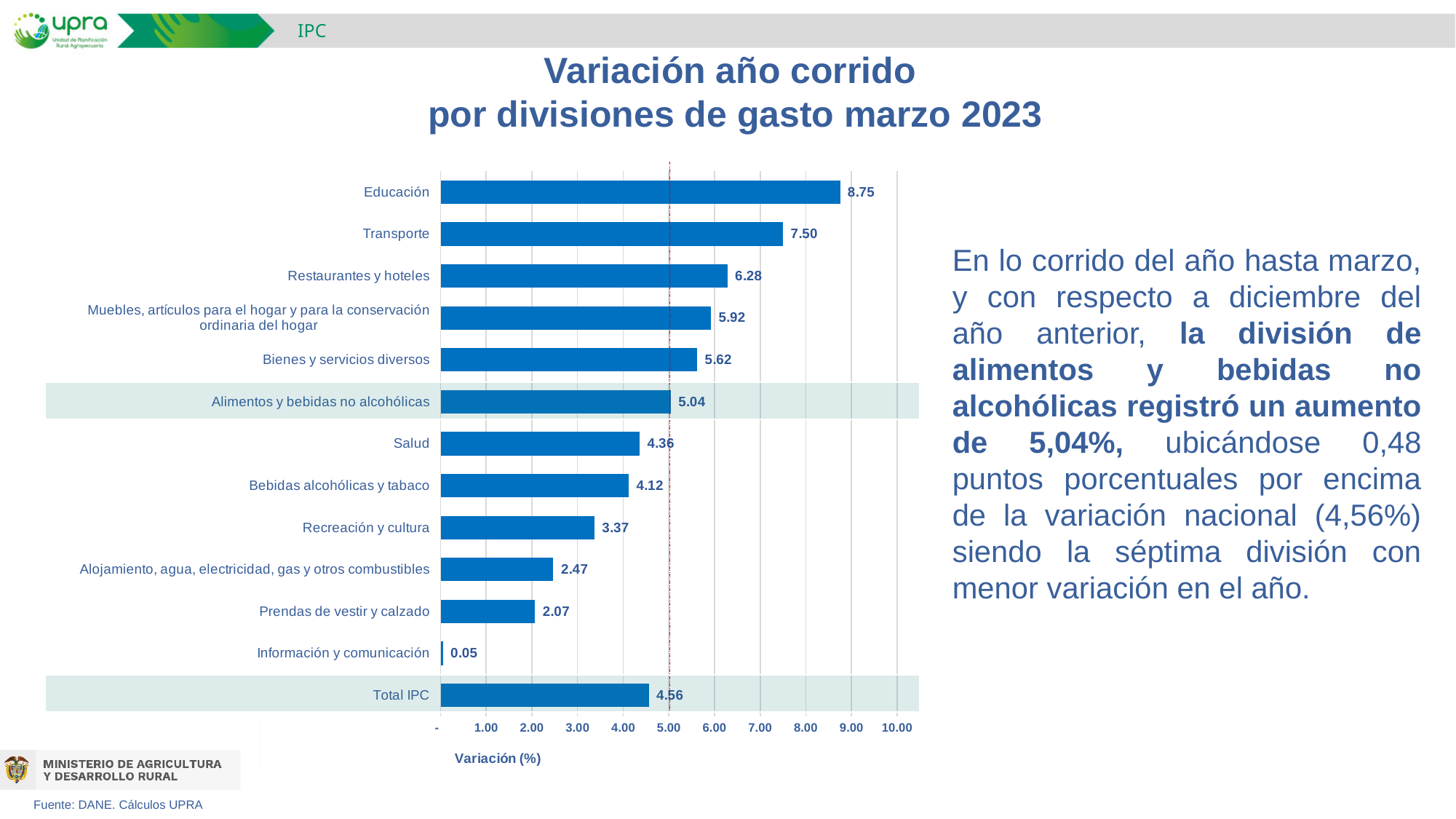
What is the value for Total IPC? 4.56 What is the difference between the values for Alimentos y bebidas no alcohólicas and Total IPC? 0.48 How many categories (bars) are shown in the chart? 13 What is the value for Alimentos y bebidas no alcohólicas? 5.04 What is the label of the horizontal axis? Variación (%) What kind of chart is shown on the slide? Bar chart Which is larger, the value for Salud or the value for Bebidas alcohólicas y tabaco? Salud Which category has the lowest value? Información y comunicación Which category has the highest value? Educación Is the value for Restaurantes y hoteles greater or less than 6.00? greater What is the value for Educación? 8.75 What is the difference between the values for Educación and Transporte? 1.25